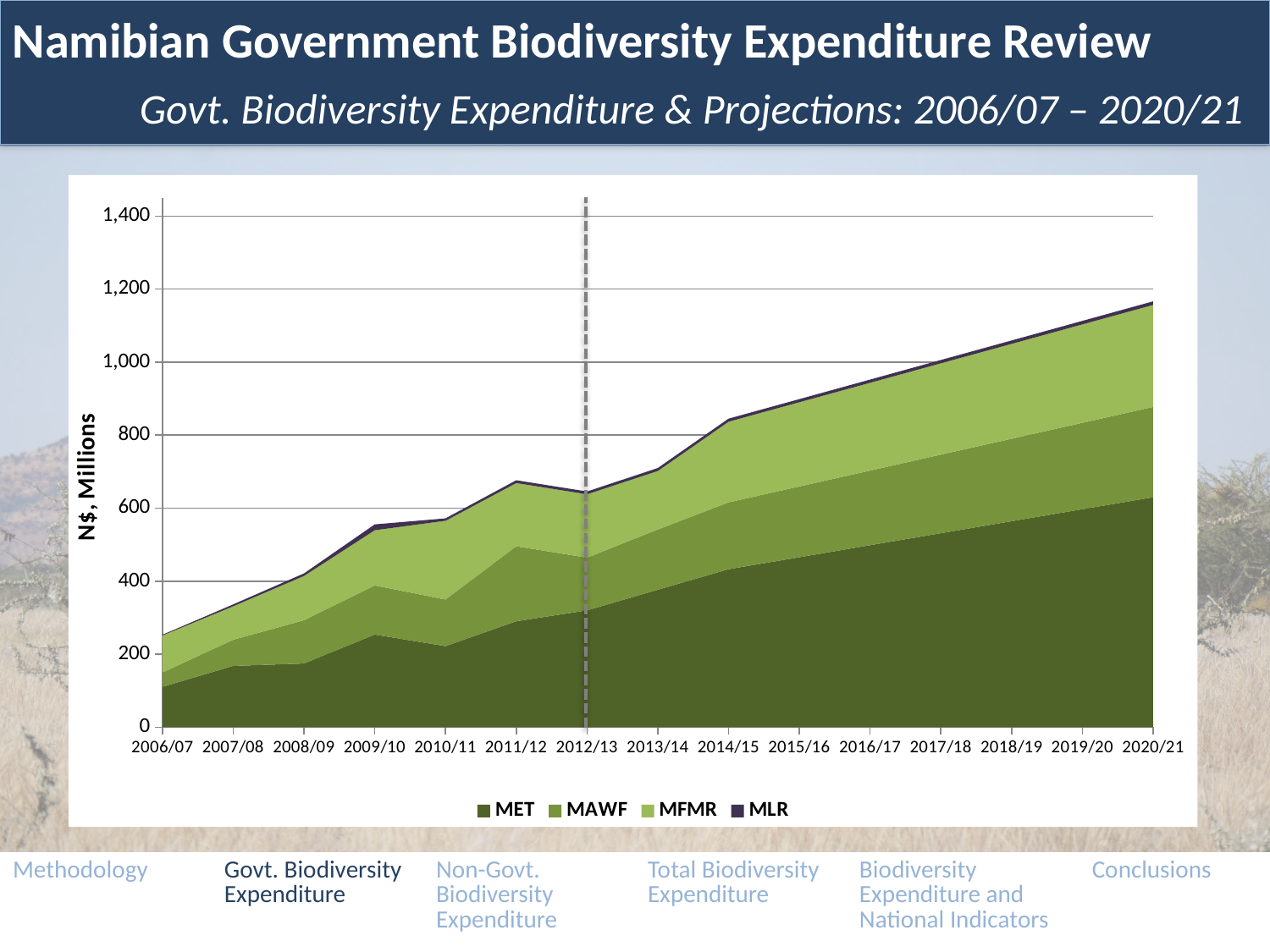
Which year has the highest total expenditure? 2020/21 What kind of chart is shown on the slide? Stacked area chart Does total government biodiversity expenditure generally rise or fall from 2006/07 to 2020/21? Rise Is the total expenditure for 2020/21 greater or less than 1,000? greater How many fiscal years are shown along the x axis? 15 Which series forms the bottom layer of the stacked area? MET Is the MET expenditure for 2020/21 greater or less than 400? greater What is the label on the y axis? N$, Millions Is the total expenditure for 2011/12 greater or less than 2010/11? 2011/12 is greater Is the total expenditure for 2006/07 greater or less than 400? less Which year has the lowest total expenditure? 2006/07 How many series does the legend list? 4